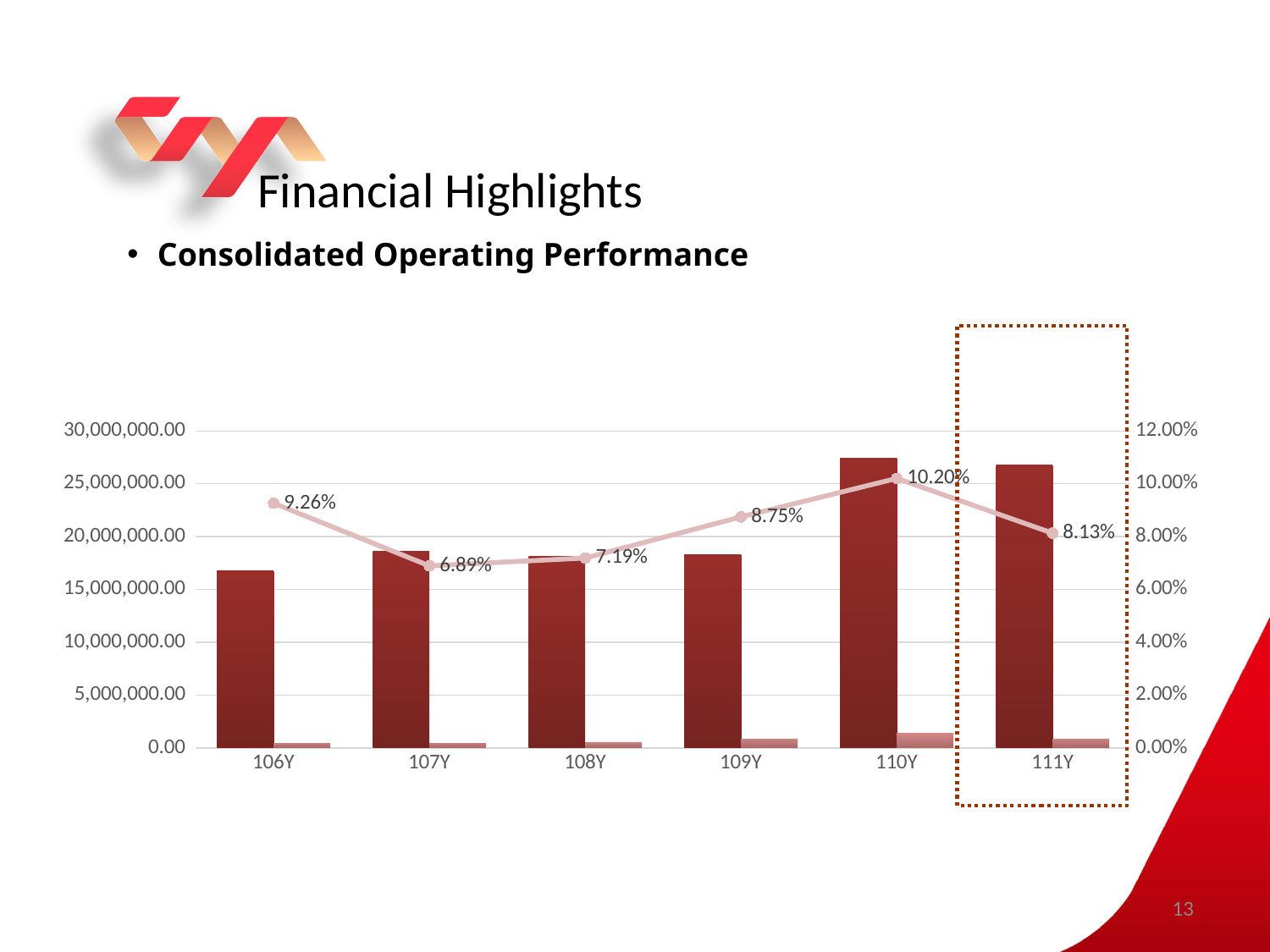
Is the value of the tall bar for 110Y greater or less than 25,000,000.00? greater What is the percentage value shown on the line for 107Y? 6.89% What is the percentage value shown on the line for 111Y? 8.13% How many year categories are shown on the x axis? 6 In which year does the line series reach its lowest percentage? 107Y What is the percentage value shown on the line for 110Y? 10.20% Is the value of the tall bar for 106Y greater or less than 20,000,000.00? less What is the percentage value shown on the line for 106Y? 9.26% By how many percentage points does the line value for 110Y exceed the line value for 111Y? 2.07 percentage points In which year does the line series reach its highest percentage? 110Y Does the line series rise or fall from 107Y to 110Y? rise Which is larger, the line value for 108Y or the line value for 109Y? 109Y